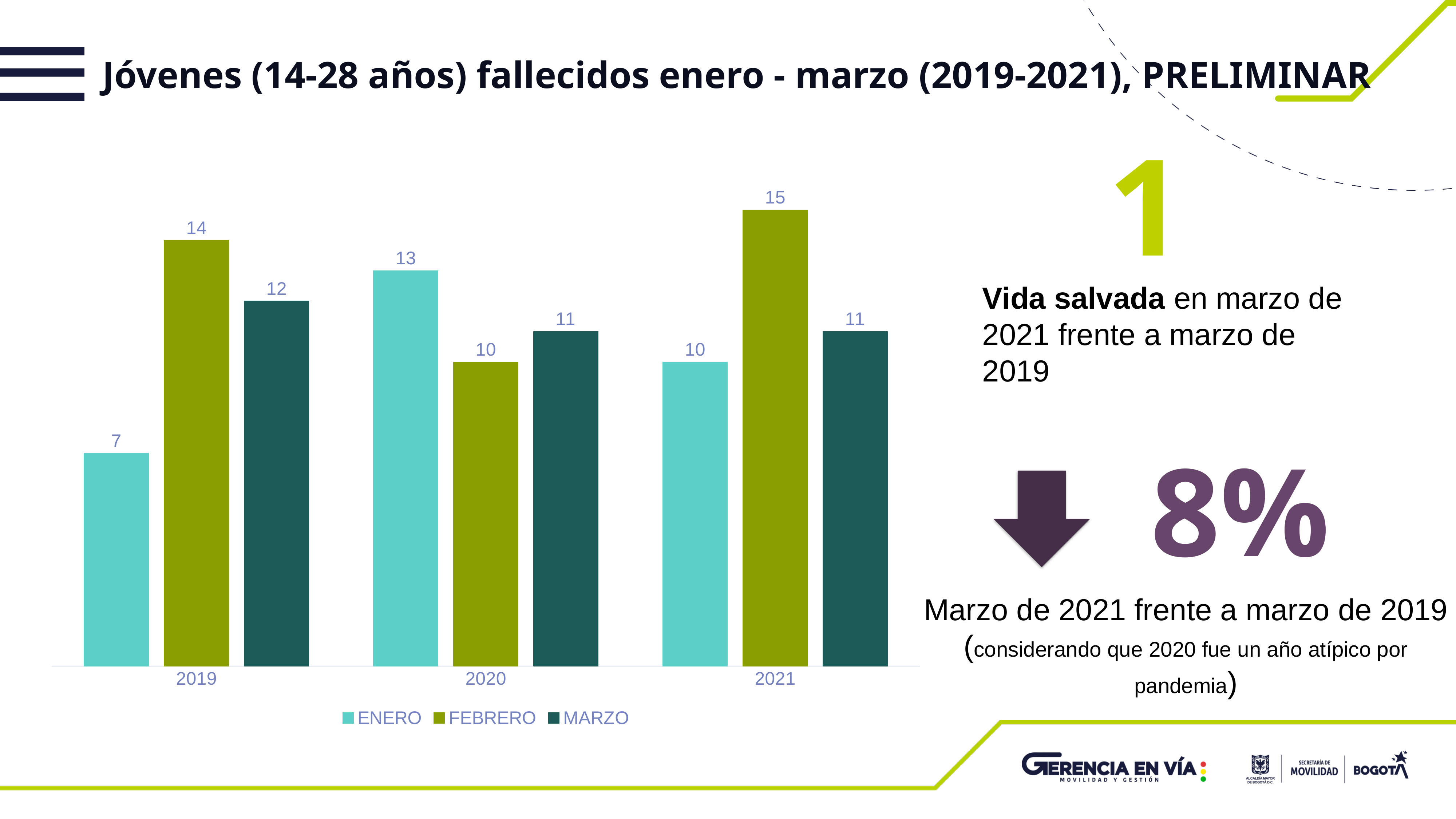
Which year has the lowest ENERO value? 2019 Which year has the highest FEBRERO value? 2021 How many series does the legend list? 3 Does the FEBRERO value rise or fall from 2020 to 2021? Rise What kind of chart is shown on the slide? Bar chart What is the value for ENERO in 2019? 7 Which is larger, ENERO in 2020 or ENERO in 2021? ENERO in 2020 What is the value for MARZO in 2020? 11 What is the value for FEBRERO in 2021? 15 Which series is shown in the darkest green colour? MARZO How many years are shown on the x axis? 3 What is the difference between the MARZO values for 2019 and 2021? 1